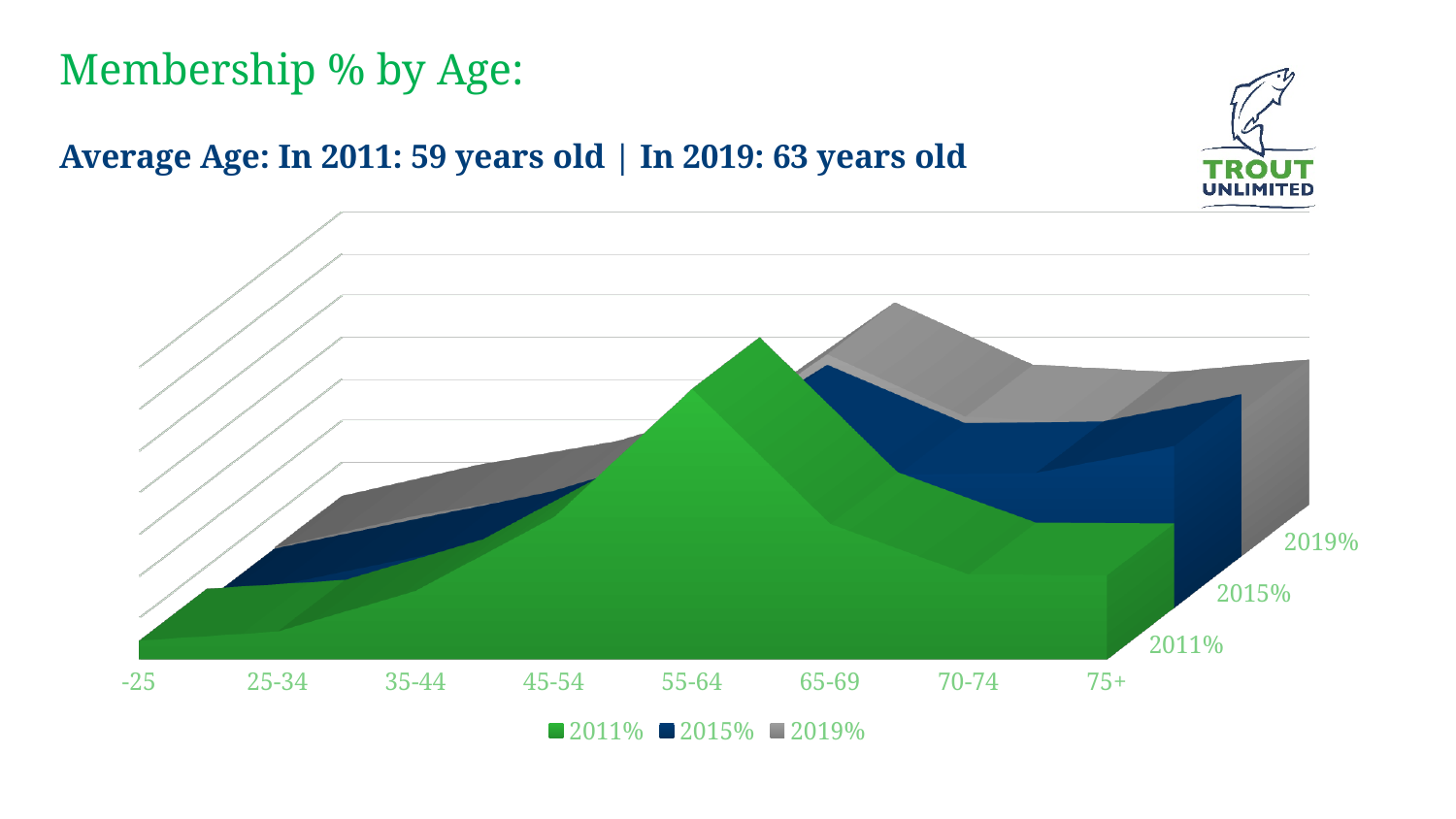
What kind of chart is shown on the slide? Area chart Which series is shown in green? 2011% Which age category has the highest value for the 2015% series? 55-64 Does the 2011% series rise or fall from -25 to 55-64? Rise Which age category has the lowest value for the 2011% series? -25 For the 2011% series, is the value for 55-64 larger or smaller than the value for -25? Larger Which age category has the highest value for the 2011% series? 55-64 Does the 2011% series rise or fall from 55-64 to 75+? Fall What is the title of the chart? Membership % by Age: Which age category has the highest value for the 2019% series? 55-64 How many series does the legend list? 3 How many age categories are shown on the x axis? 8